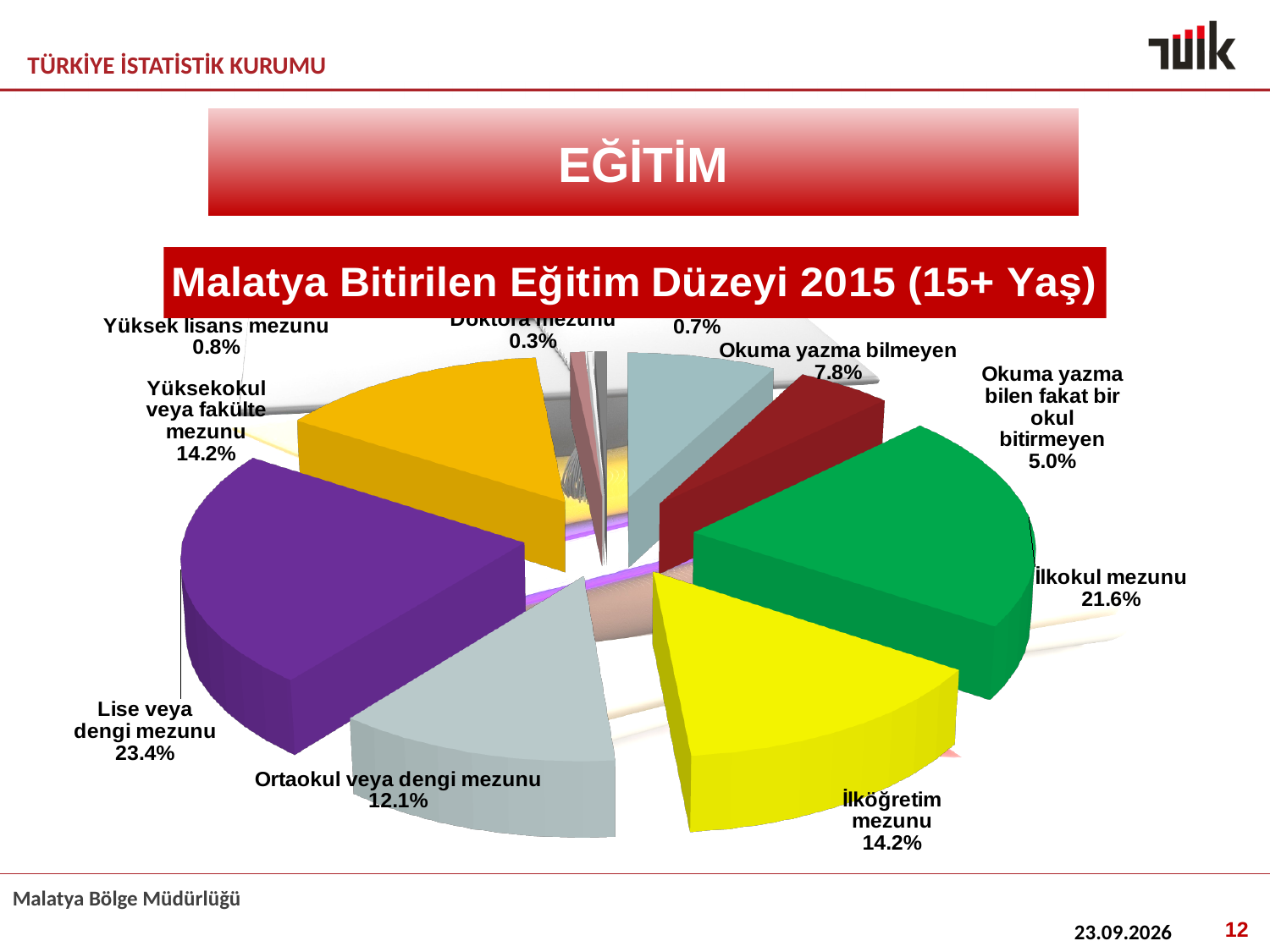
What is the value for 'İlkokul mezunu'? 21.6% Which category has the largest share of the pie? Lise veya dengi mezunu Which category has the smallest share of the pie? Doktora mezunu What is the value for 'Okuma yazma bilen fakat bir okul bitirmeyen'? 5.0% What is the title of the chart? Malatya Bitirilen Eğitim Düzeyi 2015 (15+ Yaş) What share of the pie is 'Lise veya dengi mezunu'? 23.4% What is the value for 'Yüksek lisans mezunu'? 0.8% What is the value for 'Ortaokul veya dengi mezunu'? 12.1% Which is larger, 'Okuma yazma bilmeyen' or 'Okuma yazma bilen fakat bir okul bitirmeyen'? Okuma yazma bilmeyen What is the value for 'Okuma yazma bilmeyen'? 7.8% What kind of chart is shown on the slide? pie chart What is the difference between 'Lise veya dengi mezunu' and 'İlkokul mezunu'? 1.8%